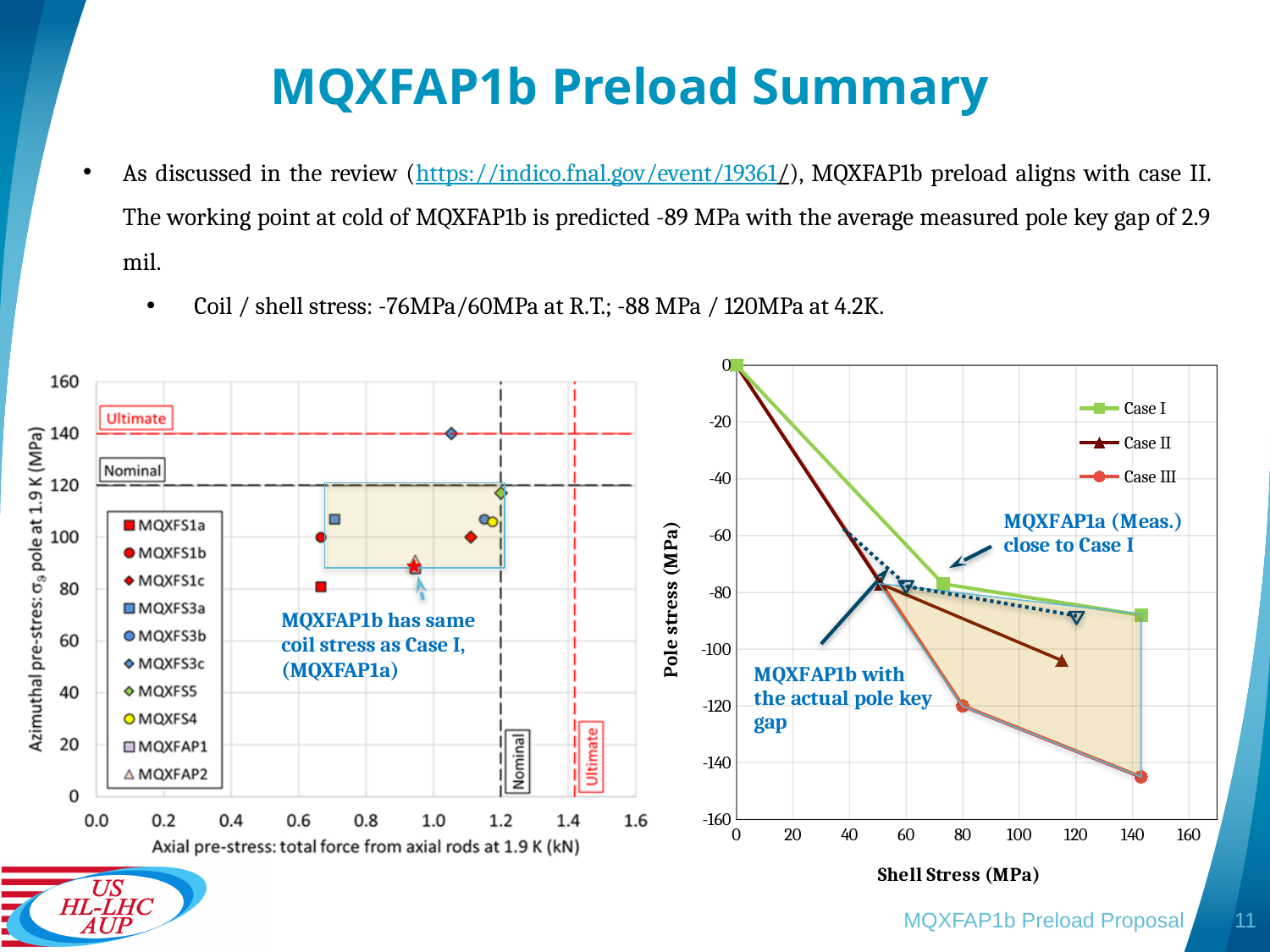
What kind of chart is the chart on the right (Pole stress vs Shell Stress)? line chart In the right chart (Pole stress vs Shell Stress), which series reaches the lowest pole stress value? Case III How many magnet entries does the legend of the left chart (Azimuthal pre-stress vs Axial pre-stress) list? 10 In the left chart (Azimuthal pre-stress vs Axial pre-stress), at what azimuthal pre-stress value is the horizontal 'Ultimate' line drawn? 140 In the left chart (Azimuthal pre-stress vs Axial pre-stress), is the azimuthal pre-stress for MQXFS1a greater or less than 100? less How many series does the legend of the right chart (Pole stress vs Shell Stress) list? 3 In the right chart (Pole stress vs Shell Stress), at the highest shell stress plotted, which series has the higher (less negative) pole stress, Case I or Case III? Case I In the left chart (Azimuthal pre-stress vs Axial pre-stress), which magnet has the highest azimuthal pre-stress? MQXFS3c In the right chart (Pole stress vs Shell Stress), does the pole stress for Case III rise or fall as shell stress increases? fall In the right chart (Pole stress vs Shell Stress), is the final pole stress value of Case III greater or less than -140? less In the right chart (Pole stress vs Shell Stress), is the final pole stress value of Case I greater or less than -100? greater What is the x-axis label of the right chart? Shell Stress (MPa)